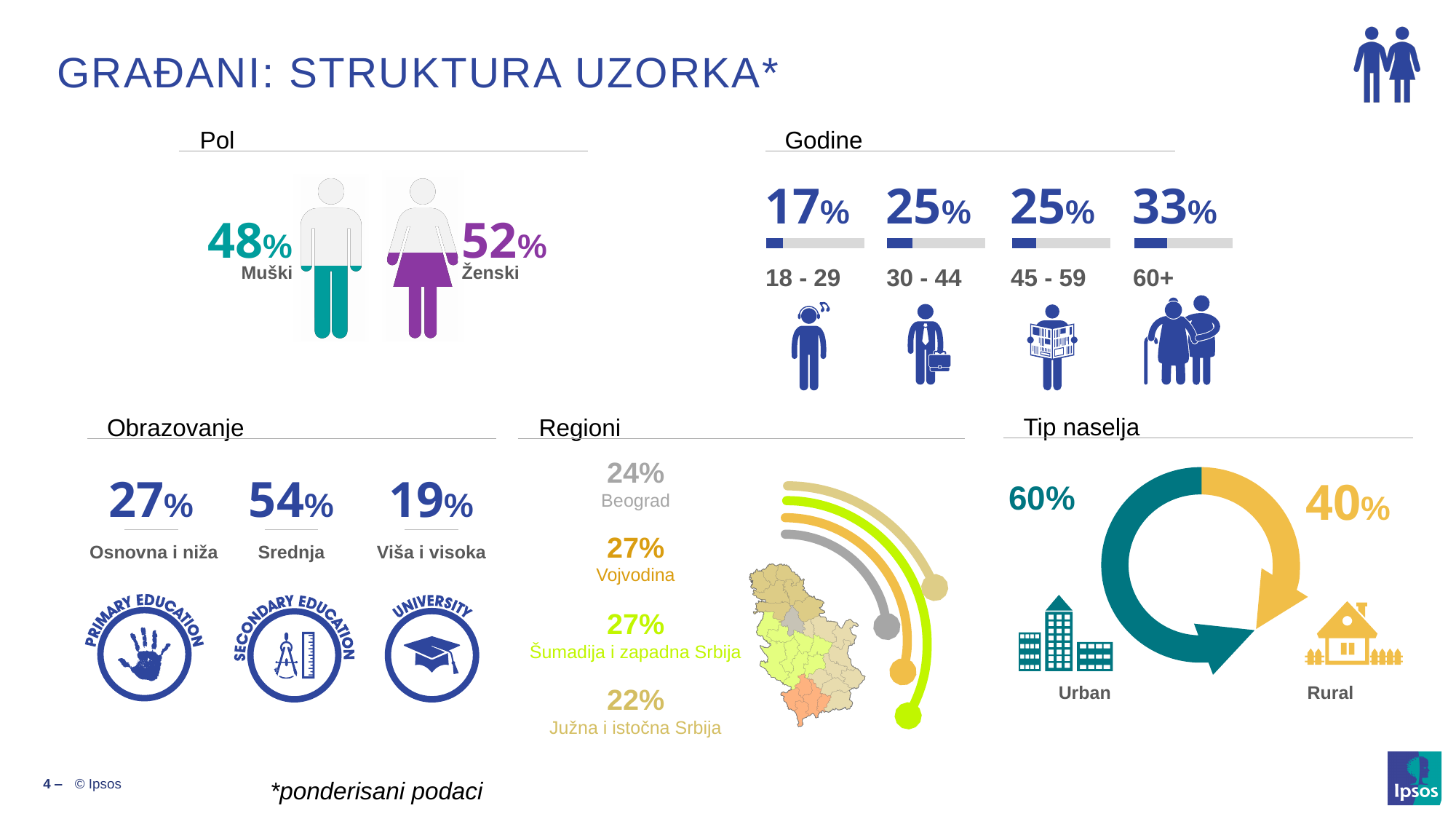
In the Godine section, how many age groups are shown? 4 In the Regioni section, which region has the lowest share? Južna i istočna Srbija In the Godine section, which age group has the highest share? 60+ In the Tip naselja section, what is the difference between the Urban and Rural shares? 20 percentage points In the Pol section, what percentage of the sample is Muški? 48% In the Regioni section, what is the share for Beograd? 24% In the Obrazovanje section, which category is larger: Osnovna i niža or Viša i visoka? Osnovna i niža In the Godine section, which age group has the lowest share? 18 - 29 In the Godine section, what is the difference between the 60+ share and the 18 - 29 share? 16 percentage points In the Tip naselja section, what is the share for Rural? 40% In the Obrazovanje section, what is the share for Srednja? 54% In the Pol section, what percentage of the sample is Ženski? 52%